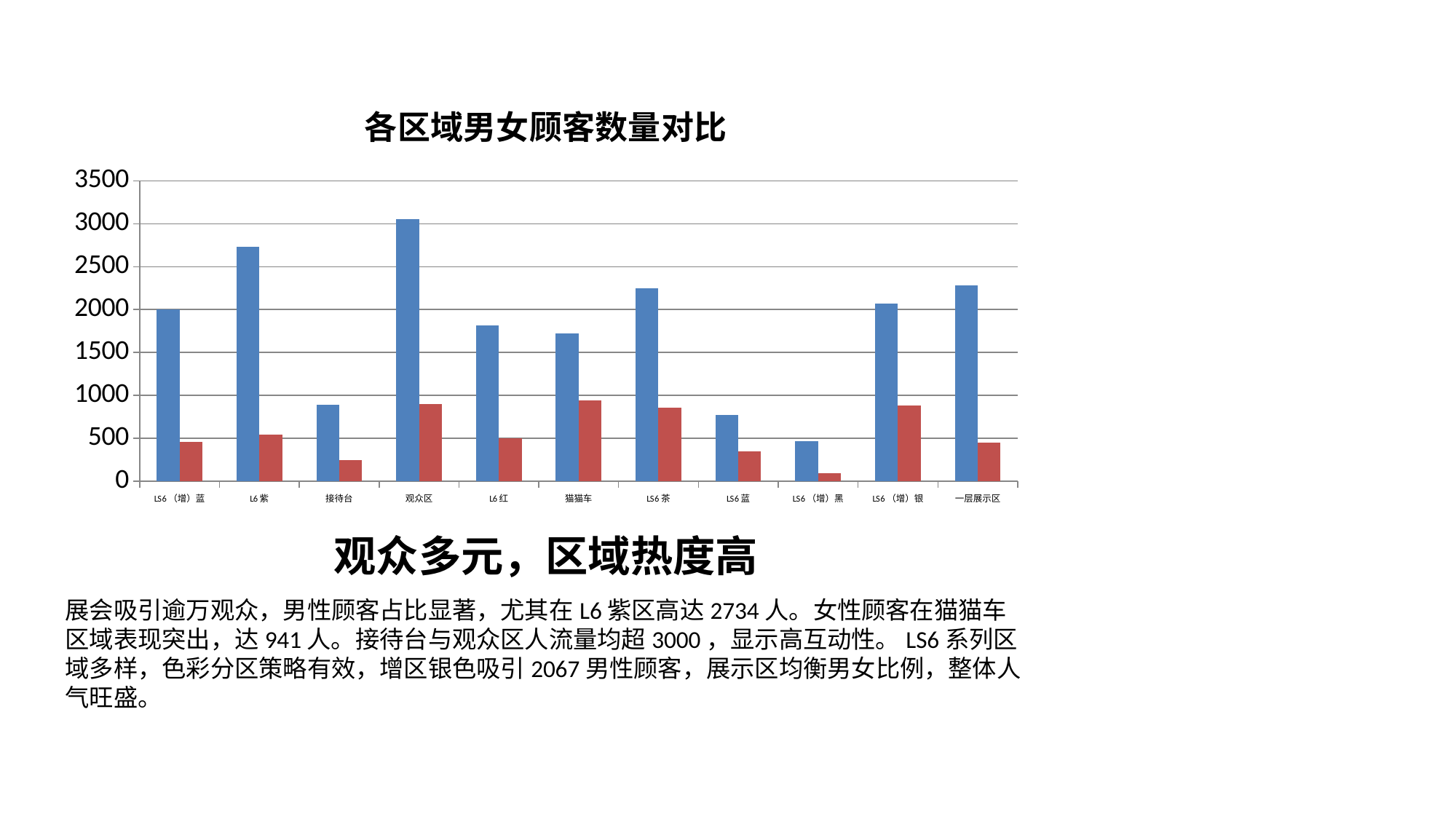
Which category has the shortest blue bar? LS6（增）黑 Which has the larger blue bar, L6 紫 or LS6 茶? L6 紫 Is the blue bar for 一层展示区 greater or less than 2000? greater Which category has the tallest blue bar? 观众区 Is the red bar for 猫猫车 greater or less than 1000? less Is the blue bar for 观众区 greater or less than 3000? greater What type of chart is shown on the slide? bar chart What is the title of the chart? 各区域男女顾客数量对比 Which category has the shortest red bar? LS6（增）黑 How many categories (regions) are shown on the x axis of the chart? 11